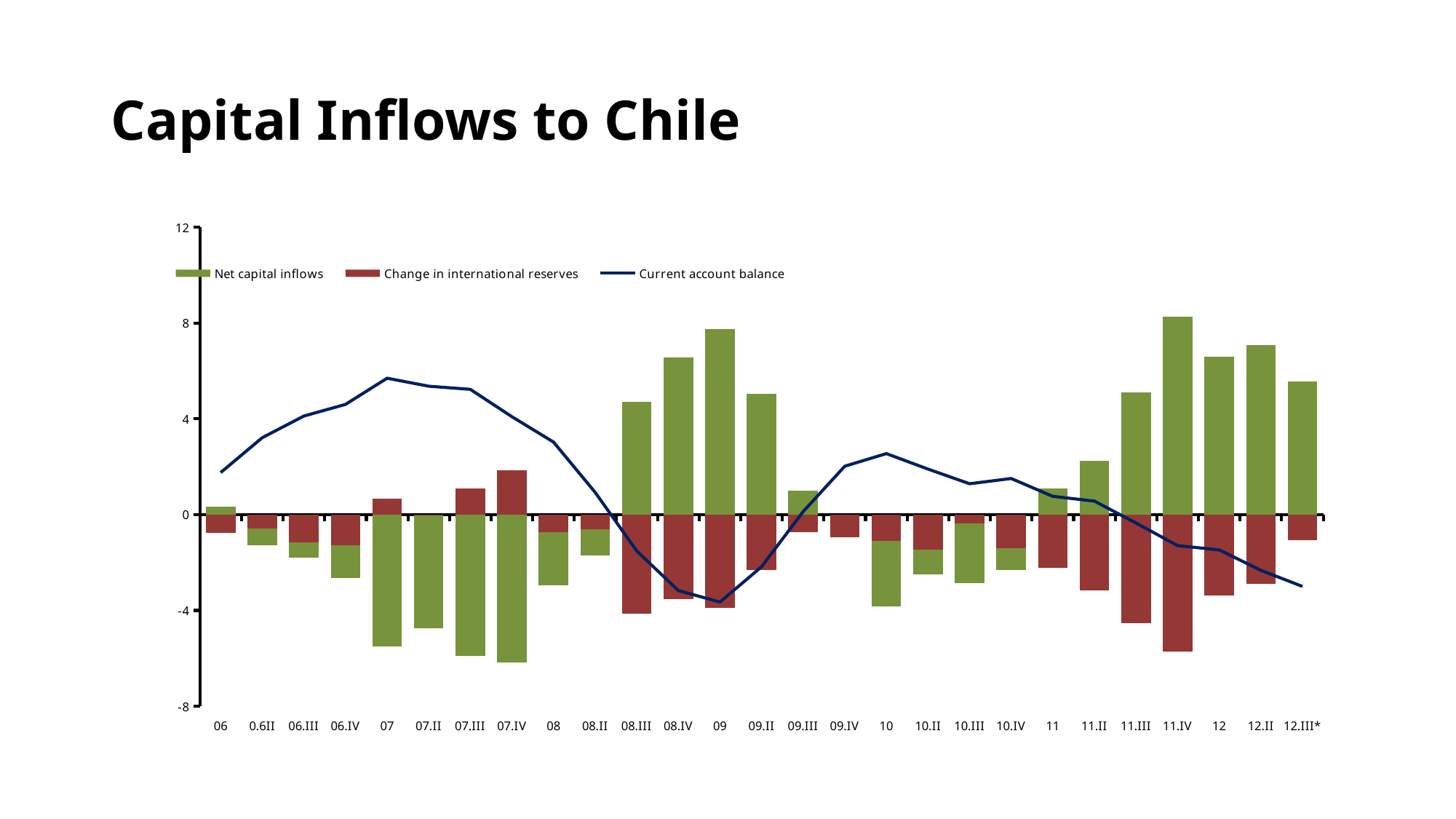
Which series is drawn as a line rather than bars? Current account balance In which period does the Current account balance line reach its highest point? 07 How many time periods are shown on the x axis? 27 How many series does the legend list? 3 Is the value of Change in international reserves for 11.IV greater or less than -4? less Is the value of Net capital inflows for 08.IV greater or less than 4? greater What kind of chart is this? Combined bar and line chart Which is larger, Net capital inflows for 08.IV or for 09.II? 08.IV In which period is Net capital inflows highest? 11.IV In which period is Change in international reserves lowest? 11.IV In which period is Change in international reserves highest? 07.IV What is the title of the chart? Capital Inflows to Chile